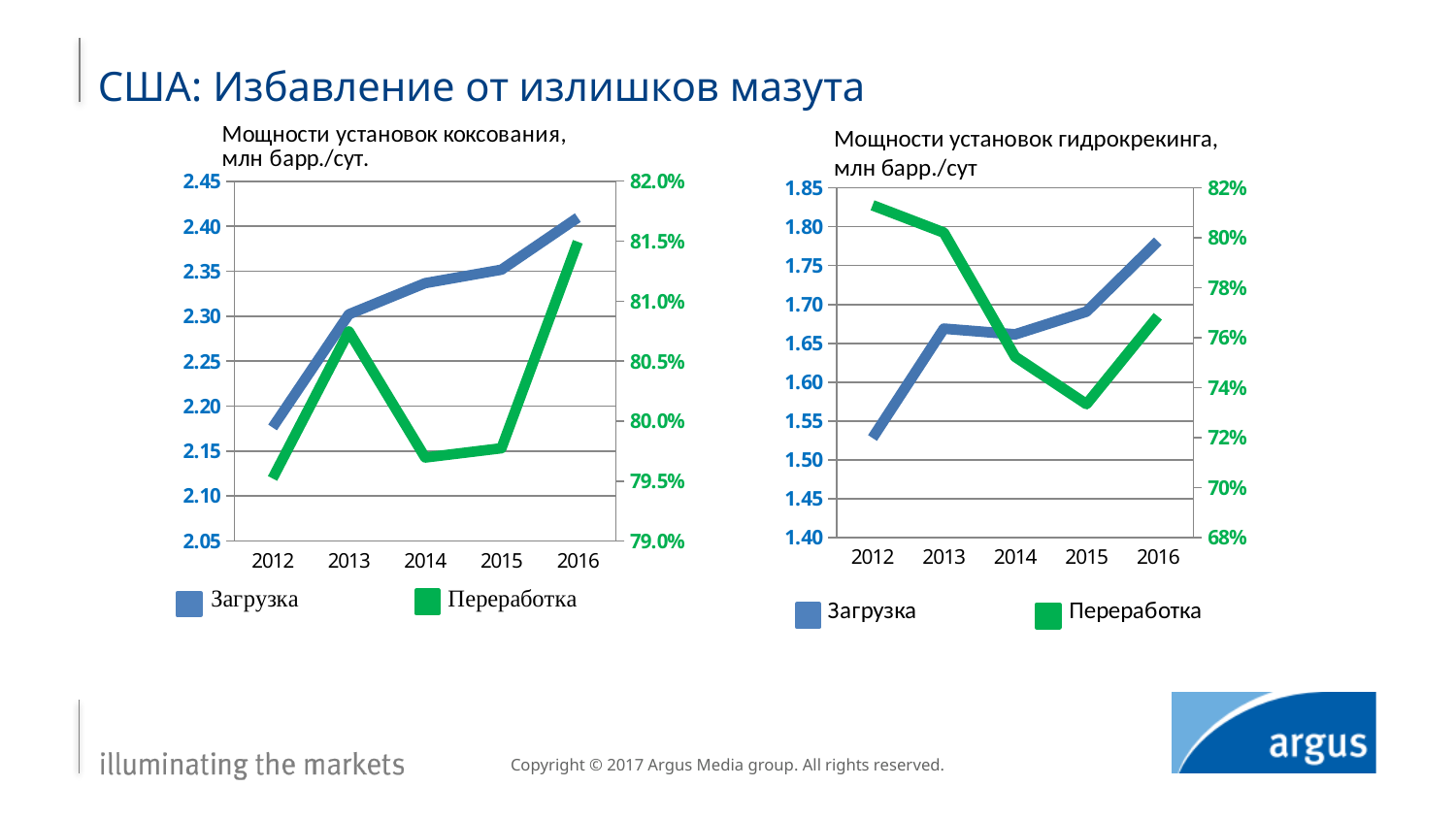
In the left chart (Мощности установок коксования), is the Переработка value for 2016 greater or less than 81.0%? greater What kind of chart is the left chart titled 'Мощности установок коксования, млн барр./сут.'? line chart In the left chart (Мощности установок коксования), in which year is Загрузка lowest? 2012 In the left chart (Мощности установок коксования), does the Загрузка line rise or fall from 2012 to 2016? rise In the left chart (Мощности установок коксования), in which year is Загрузка highest? 2016 In the left chart (Мощности установок коксования), how many series does the legend list? 2 In the right chart (Мощности установок гидрокрекинга), in which year is Переработка highest? 2012 In the left chart (Мощности установок коксования), is the Загрузка value for 2012 greater or less than 2.20? less In the right chart (Мощности установок гидрокрекинга), which year has the larger Загрузка value, 2012 or 2016? 2016 In the right chart (Мощности установок гидрокрекинга), is the Загрузка value for 2016 greater or less than 1.75? greater In the right chart (Мощности установок гидрокрекинга), how many years are plotted on the x axis? 5 In the right chart (Мощности установок гидрокрекинга), in which year is Переработка lowest? 2015